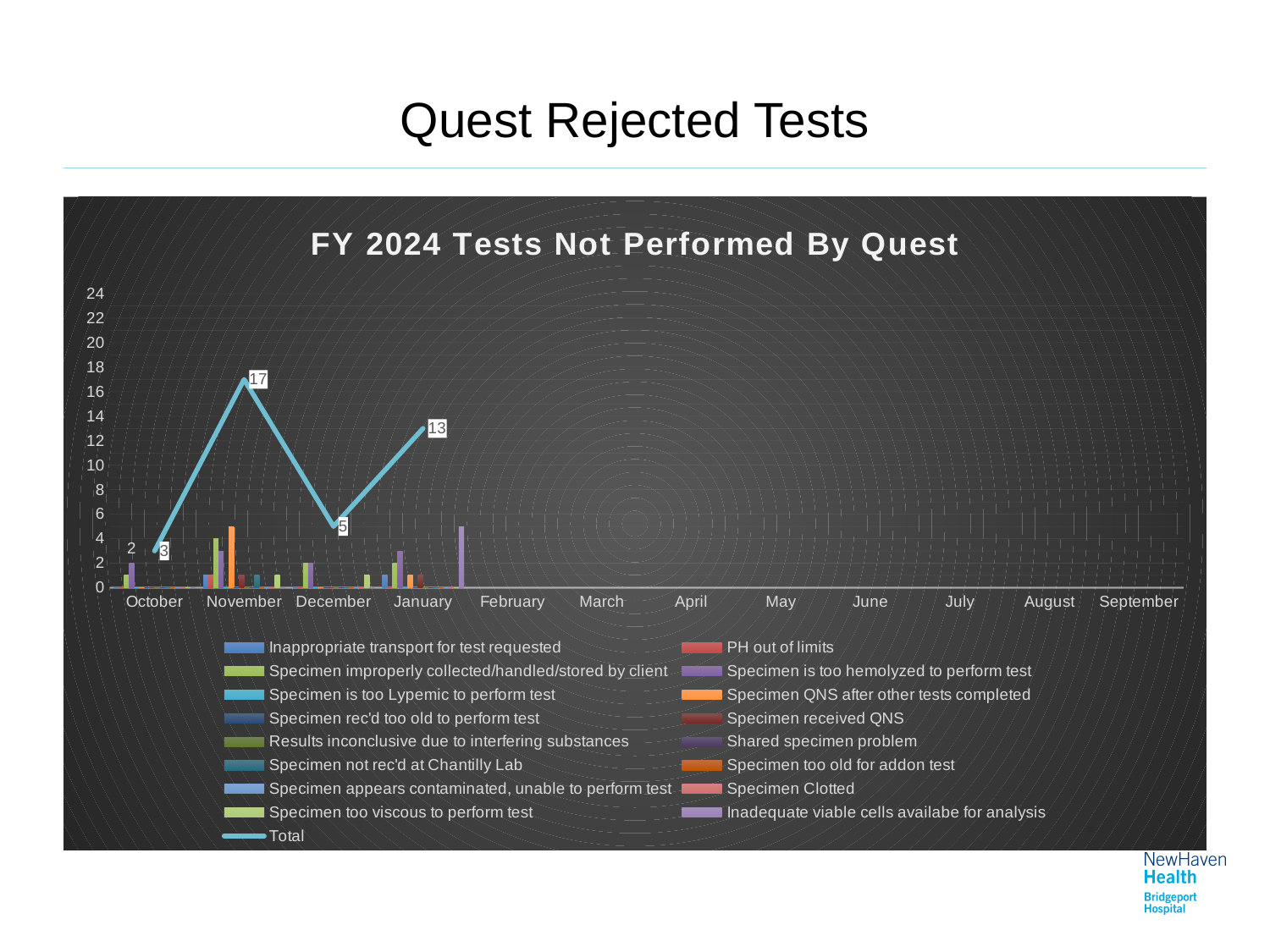
Does the Total line rise or fall from October to November? Rise What is the difference between the Total for November and the Total for December? 12 What kind of chart is this? Combined bar and line chart How many series does the legend list? 17 How many months are shown on the x axis? 12 What is the Total value for November? 17 What is the Total value for December? 5 Among the months with a labeled Total value, which has the lowest? October What is the Total value for October? 3 Which is larger, the Total for January or the Total for December? January Which month has the highest Total value? November What is the Total value for January? 13